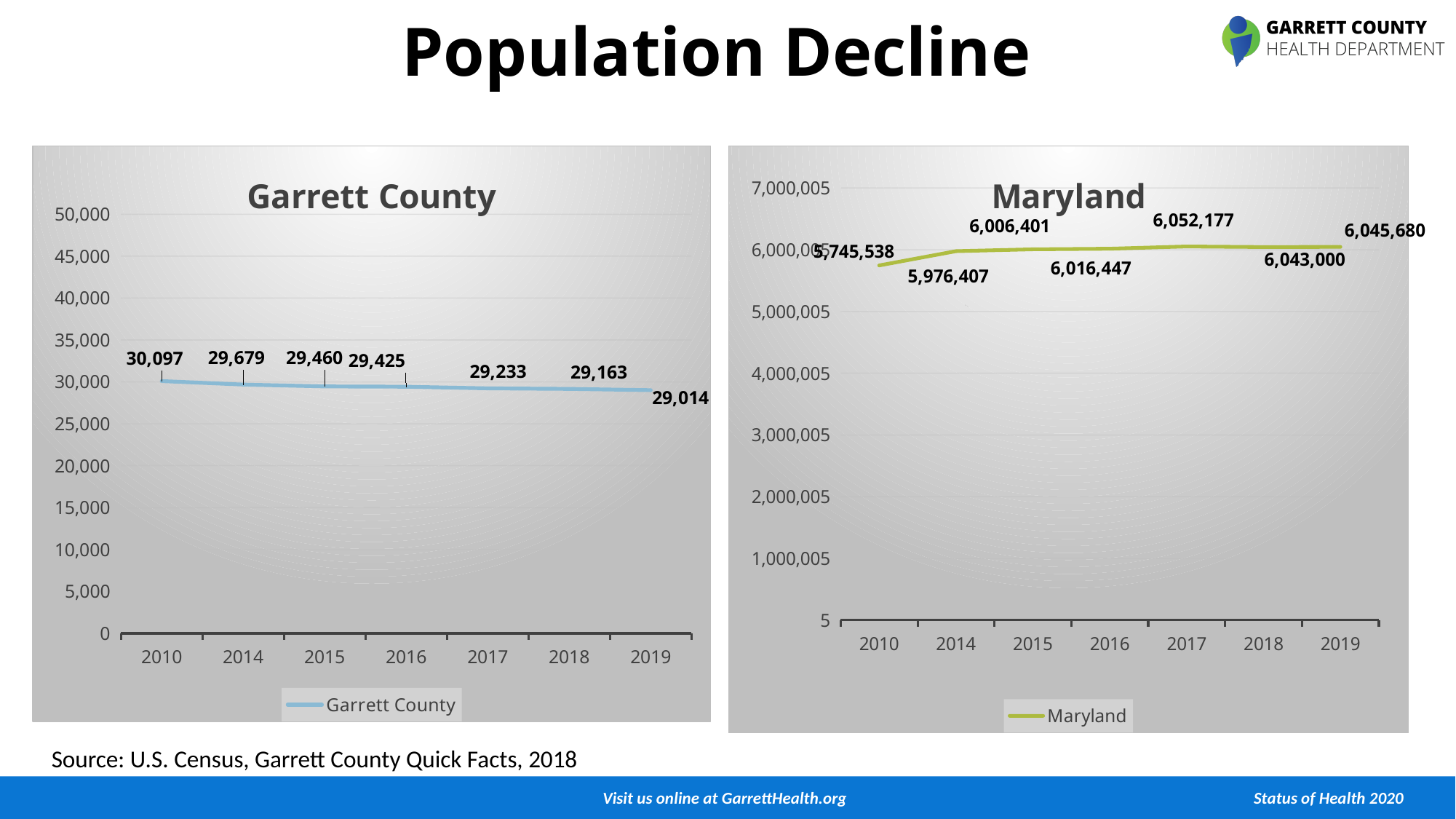
In the Garrett County chart, what was the population in 2019? 29,014 In the Maryland chart, what was the population in 2017? 6,052,177 In the Maryland chart, what was the population in 2010? 5,745,538 How many series does the legend of the Garrett County chart list? 1 In the Maryland chart, which year has the highest population? 2017 In the Garrett County chart, what is the difference between the 2010 and 2019 populations? 1,083 In the Garrett County chart, which year has the lowest population? 2019 In the Maryland chart, is the population larger in 2018 or 2019? 2019 How many years are plotted in the Garrett County chart? 7 In the Garrett County chart, does the population rise or fall from 2010 to 2019? fall In the Garrett County chart, what was the population in 2010? 30,097 What type of chart is the Maryland chart? line chart